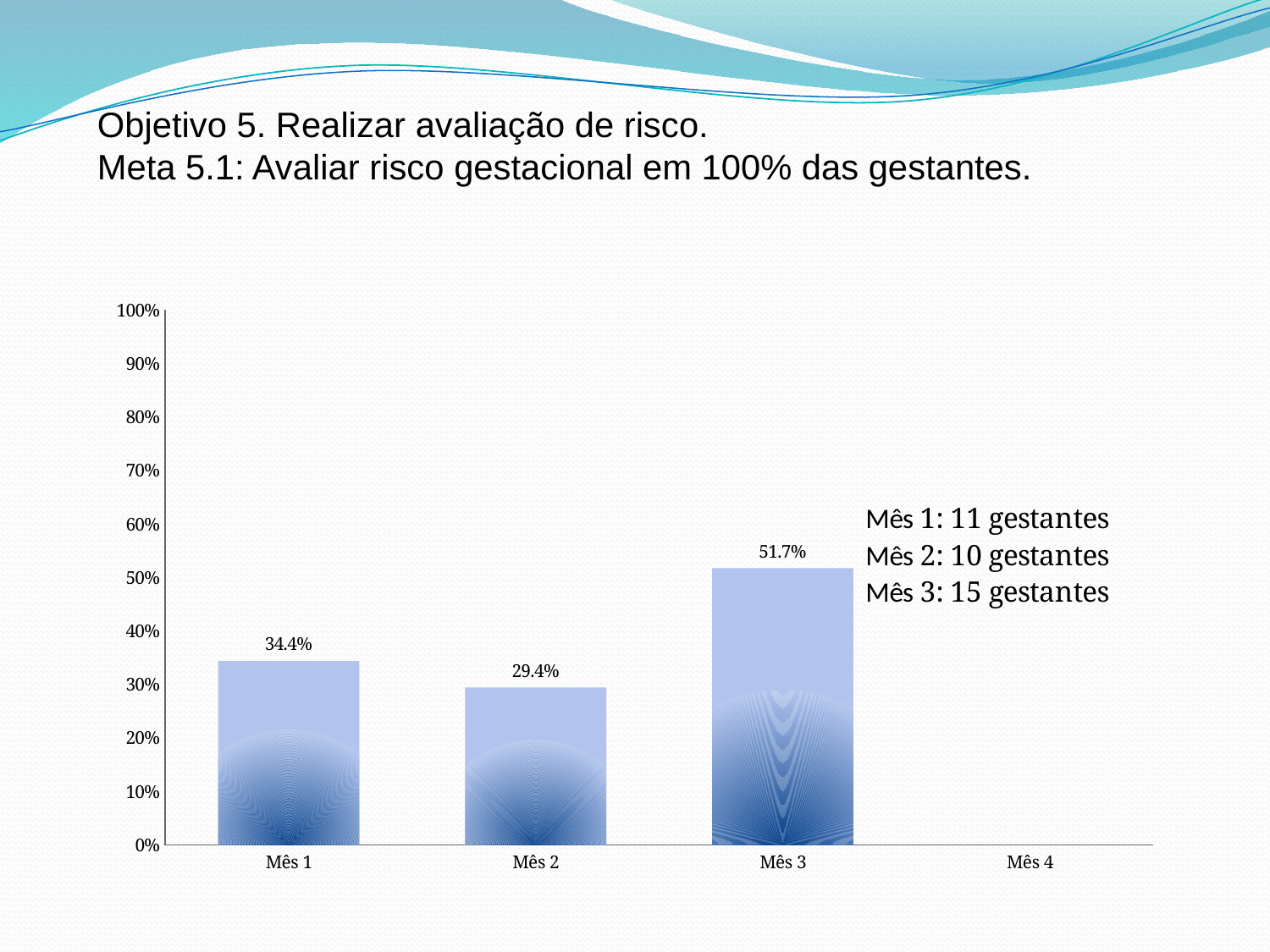
Which month has the highest value? Mês 3 What is the value for Mês 1? 34.4% What kind of chart is shown on the slide? bar chart According to the text next to the chart, how many gestantes were there in Mês 3? 15 gestantes Is the value for Mês 3 greater or less than 50%? greater How many categories are shown on the x axis? 4 What is the value for Mês 3? 51.7% Among the months with a plotted bar, which has the lowest value? Mês 2 What is the value for Mês 2? 29.4% What is the difference between the values for Mês 3 and Mês 1? 17.3% Which is larger, the value for Mês 1 or the value for Mês 2? Mês 1 What is the difference between the values for Mês 1 and Mês 2? 5.0%